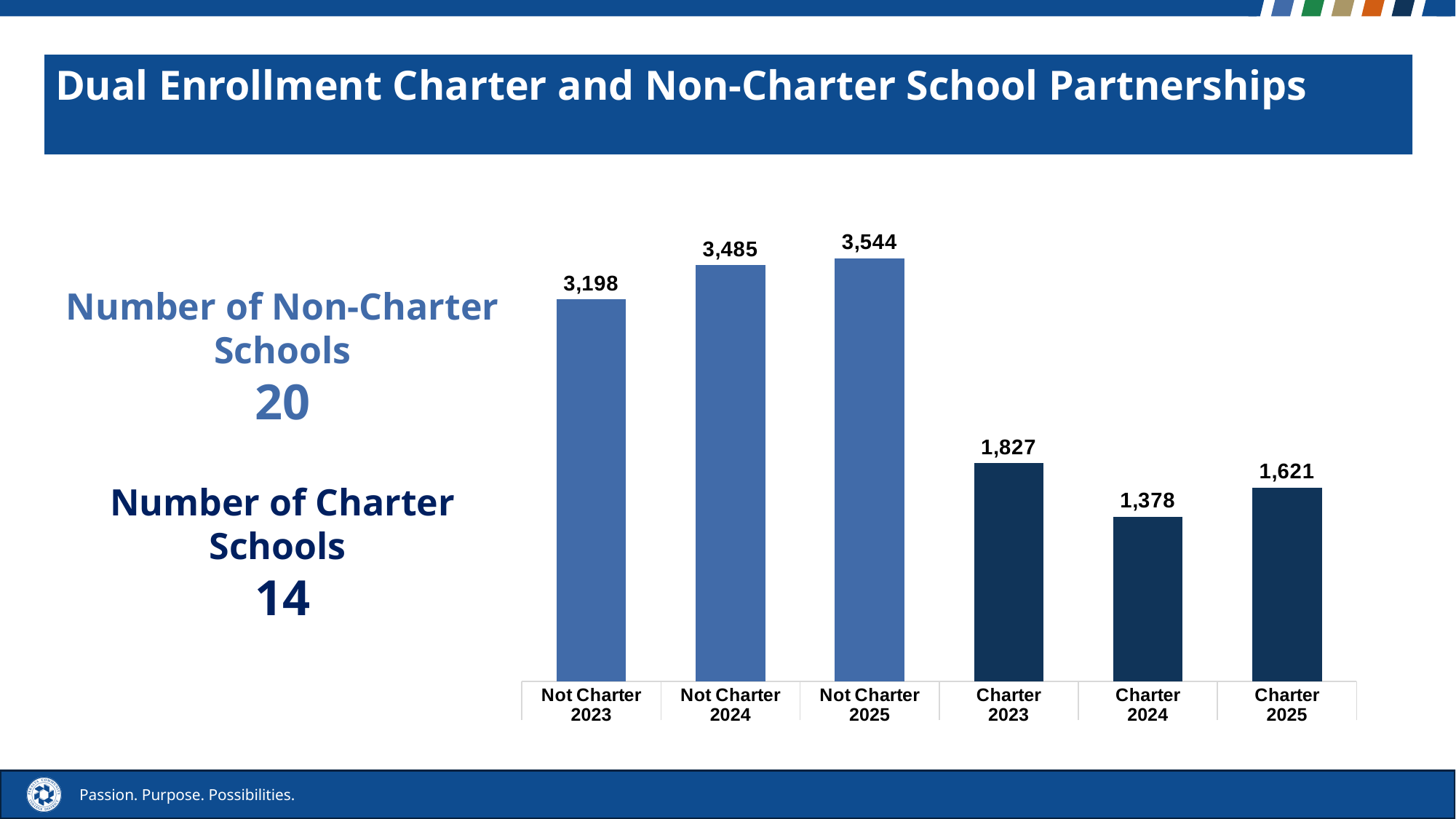
Which is larger, Charter 2023 or Charter 2025? Charter 2023 Which category has the lowest value? Charter 2024 What kind of chart is shown on the slide? Bar chart What is the value for Not Charter 2025? 3,544 What is the difference between Charter 2023 and Charter 2025? 206 What is the difference between Not Charter 2025 and Not Charter 2024? 59 What is the value for Charter 2024? 1,378 Which category has the highest value? Not Charter 2025 What is the value for Not Charter 2023? 3,198 Do the Not Charter values rise or fall from 2023 to 2025? Rise How many bars are shown in the chart? 6 What is the title of the slide containing the chart? Dual Enrollment Charter and Non-Charter School Partnerships